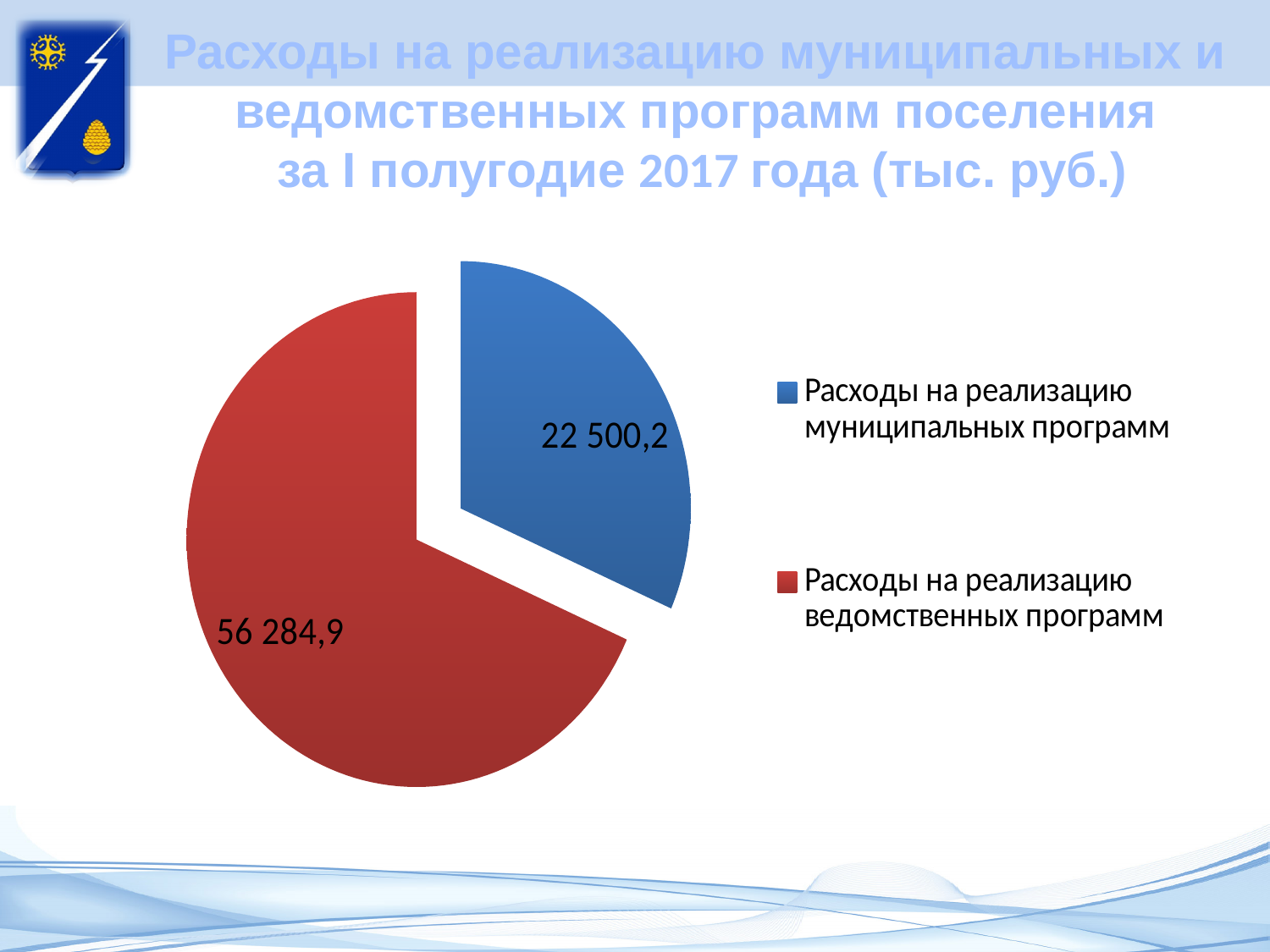
What value is shown for Расходы на реализацию муниципальных программ? 22 500,2 What is the difference between the value for ведомственных программ and the value for муниципальных программ? 33 784,7 What value is shown for Расходы на реализацию ведомственных программ? 56 284,9 Which category has the smallest slice of the pie? Расходы на реализацию муниципальных программ How many entries does the legend list? 2 What colour is the slice for Расходы на реализацию муниципальных программ? Blue What is the total of the two values shown in the pie chart? 78 785,1 Which category has the largest slice of the pie? Расходы на реализацию ведомственных программ Which is larger: the value for муниципальных программ or the value for ведомственных программ? Расходы на реализацию ведомственных программ What kind of chart is shown on the slide? Pie chart How many slices does the pie chart have? 2